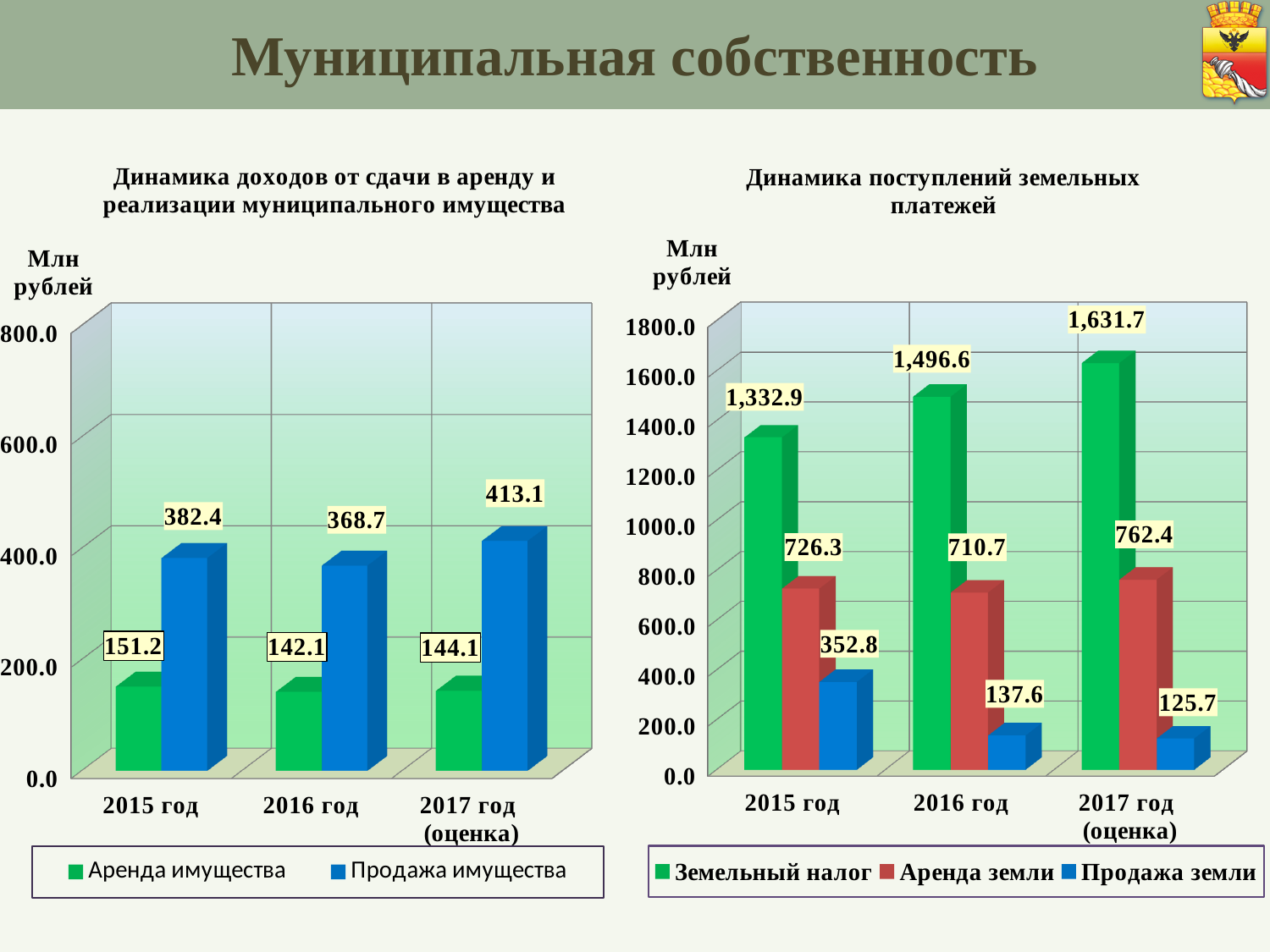
In the right chart (Динамика поступлений земельных платежей), does Земельный налог rise or fall from 2015 год to 2017 год (оценка)? rise In the right chart (Динамика поступлений земельных платежей), what is the value for Продажа земли in 2017 год (оценка)? 125.7 In the left chart (Динамика доходов от сдачи в аренду и реализации муниципального имущества), how many series does the legend list? 2 In the right chart (Динамика поступлений земельных платежей), what is the value for Земельный налог in 2016 год? 1,496.6 What kind of chart is the right chart (Динамика поступлений земельных платежей)? bar chart In the right chart (Динамика поступлений земельных платежей), which is larger in 2016 год: Аренда земли or Продажа земли? Аренда земли In the left chart (Динамика доходов от сдачи в аренду и реализации муниципального имущества), what is the value for Продажа имущества in 2017 год (оценка)? 413.1 In the right chart (Динамика поступлений земельных платежей), what is the difference between Продажа земли in 2015 год and 2016 год? 215.2 In the right chart (Динамика поступлений земельных платежей), in which year is Аренда земли highest? 2017 год (оценка) In the left chart (Динамика доходов от сдачи в аренду и реализации муниципального имущества), what is the difference between Продажа имущества and Аренда имущества in 2015 год? 231.2 In the left chart (Динамика доходов от сдачи в аренду и реализации муниципального имущества), what is the value for Аренда имущества in 2016 год? 142.1 In the left chart (Динамика доходов от сдачи в аренду и реализации муниципального имущества), in which year is Продажа имущества lowest? 2016 год